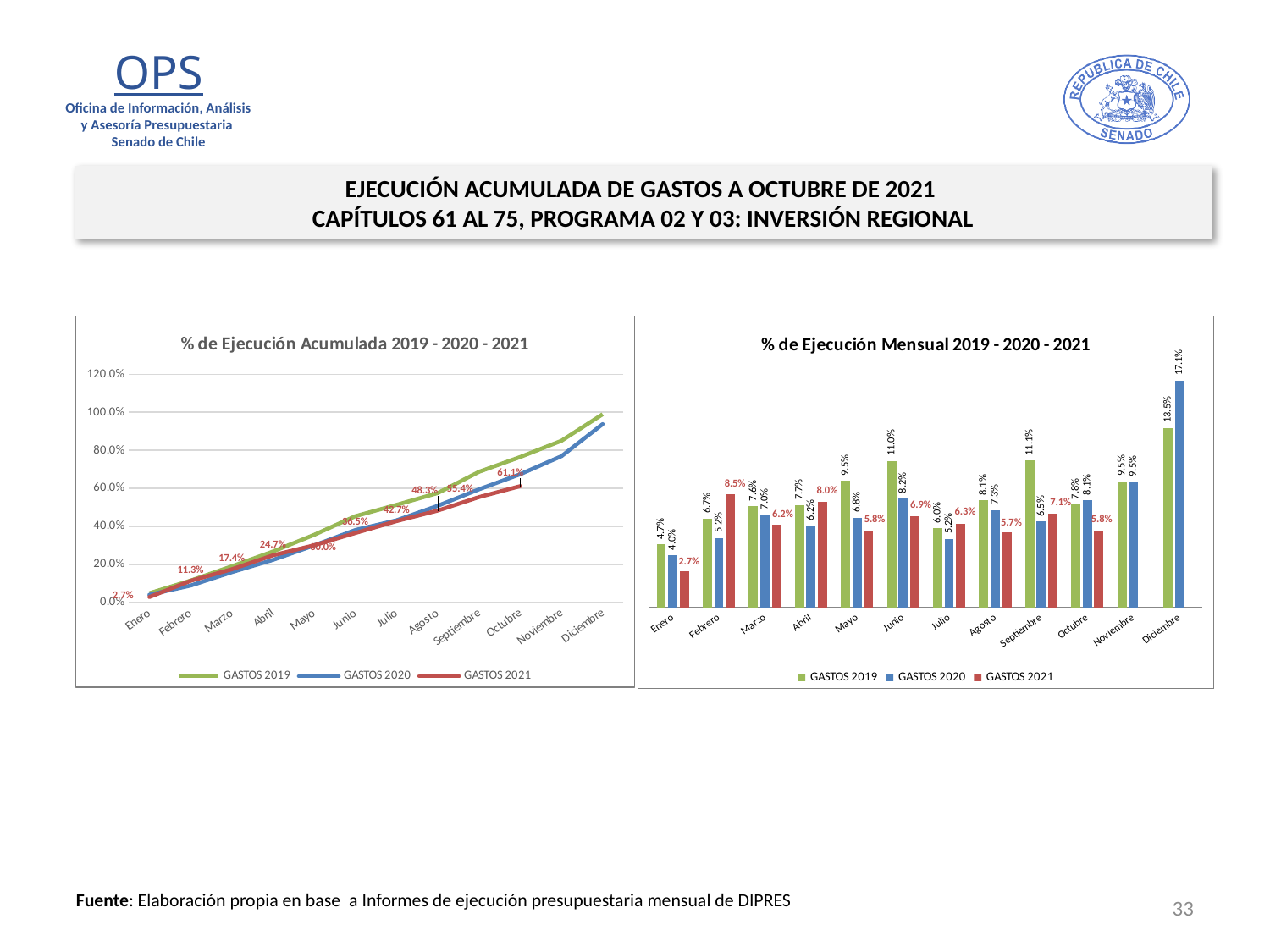
In the '% de Ejecución Acumulada 2019 - 2020 - 2021' chart, what is the difference between the GASTOS 2021 values for Octubre and Septiembre? 5.7% In the '% de Ejecución Acumulada 2019 - 2020 - 2021' chart, what is the value for GASTOS 2021 in Octubre? 61.1% In the '% de Ejecución Acumulada 2019 - 2020 - 2021' chart, does the GASTOS 2021 line rise or fall from Enero to Octubre? Rise In the '% de Ejecución Acumulada 2019 - 2020 - 2021' chart, is the value for GASTOS 2019 in Diciembre greater or less than 80.0%? greater In the '% de Ejecución Mensual 2019 - 2020 - 2021' chart, what is the difference between GASTOS 2020 and GASTOS 2019 in Diciembre? 3.6% In the '% de Ejecución Mensual 2019 - 2020 - 2021' chart, what is the value for GASTOS 2021 in Febrero? 8.5% In the '% de Ejecución Mensual 2019 - 2020 - 2021' chart, which month has the lowest value for GASTOS 2021? Enero What kind of chart is the '% de Ejecución Mensual 2019 - 2020 - 2021' chart? Bar chart How many months are shown on the x axis of the '% de Ejecución Acumulada 2019 - 2020 - 2021' chart? 12 How many series does the legend of the '% de Ejecución Acumulada 2019 - 2020 - 2021' chart list? 3 In the '% de Ejecución Mensual 2019 - 2020 - 2021' chart, which month has the highest value for GASTOS 2021? Febrero In the '% de Ejecución Mensual 2019 - 2020 - 2021' chart, which is larger in Junio: GASTOS 2019 or GASTOS 2020? GASTOS 2019